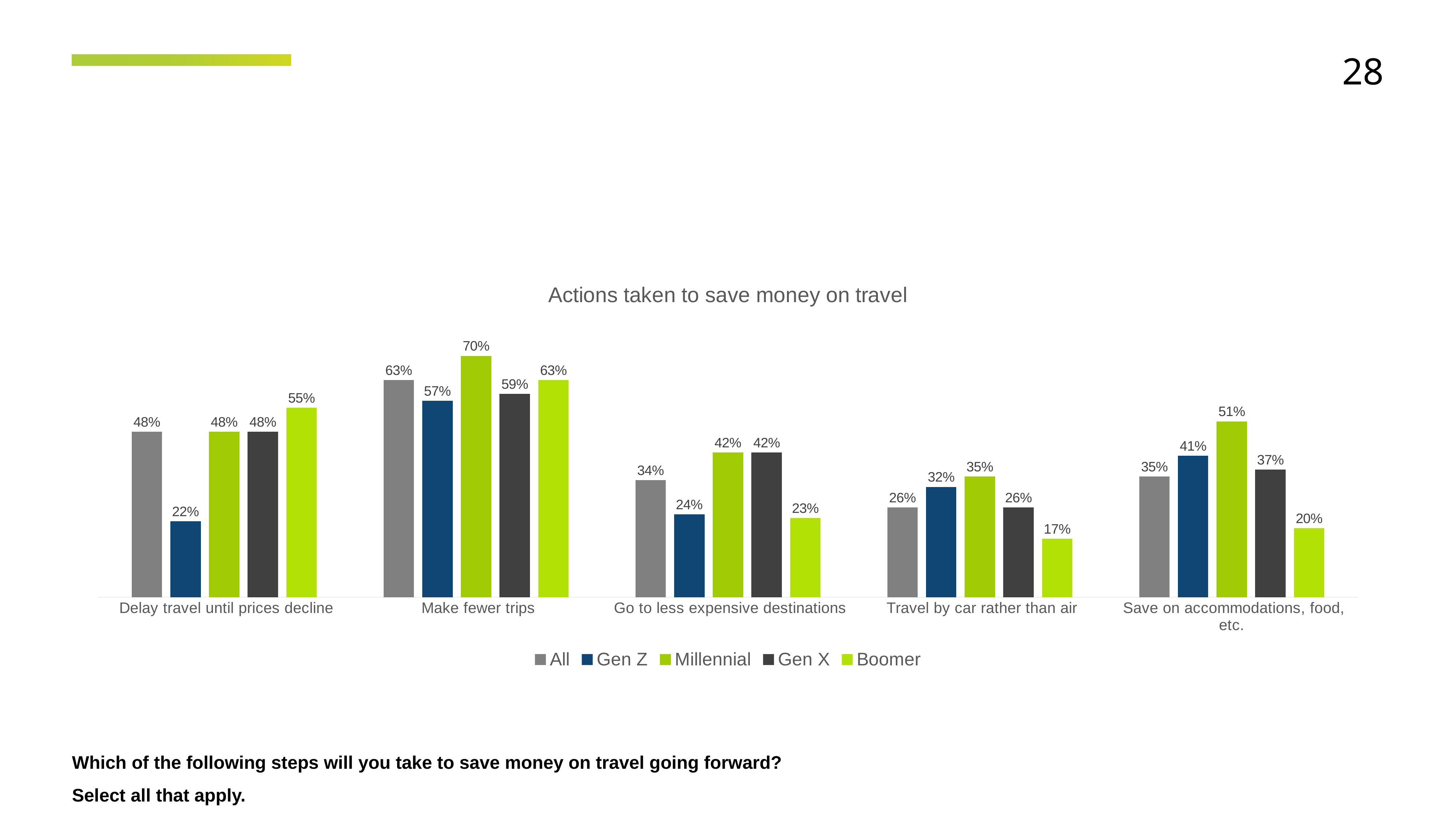
What is the value for Millennial in the 'Make fewer trips' category? 70% Which is larger in the 'Go to less expensive destinations' category: the Gen Z value or the Boomer value? Gen Z How many categories are shown on the x axis? 5 What is the value for Gen Z in the 'Delay travel until prices decline' category? 22% Which series has the lowest value in the 'Save on accommodations, food, etc.' category? Boomer How many series does the legend list? 5 Which category has the highest value for the 'All' series? Make fewer trips What kind of chart is shown on the slide? Bar chart What is the difference between the Millennial and Gen Z values in the 'Make fewer trips' category? 13% What is the title of the chart? Actions taken to save money on travel What is the difference between the Boomer and Gen Z values in the 'Delay travel until prices decline' category? 33% What is the value for Boomer in the 'Travel by car rather than air' category? 17%